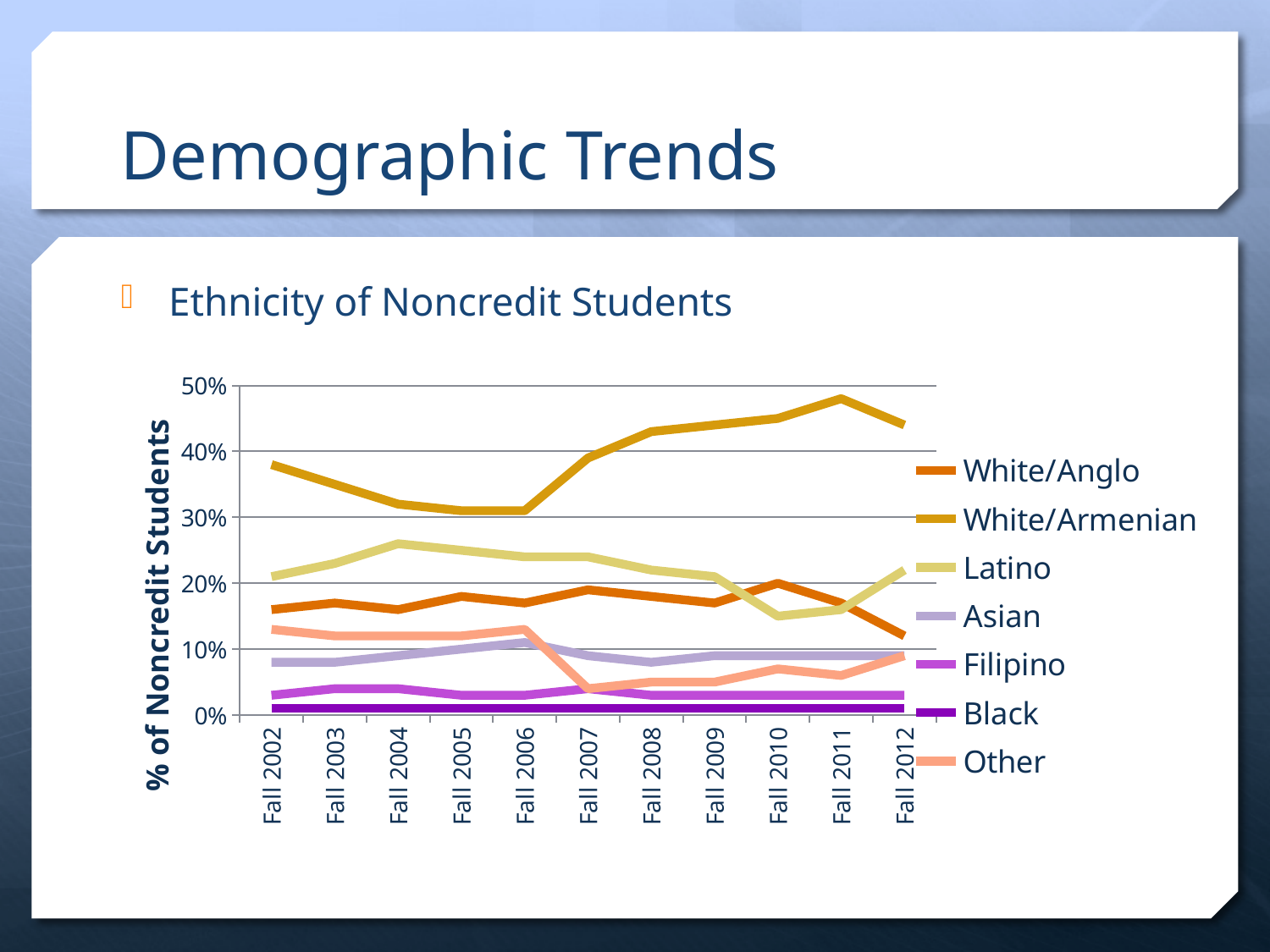
How many series does the legend list? 7 Which ethnicity has the highest percentage of noncredit students in Fall 2012? White/Armenian How many Fall terms are plotted along the x axis? 11 Is the White/Armenian value for Fall 2011 greater or less than 40%? greater Which ethnicity has the lowest percentage of noncredit students in Fall 2012? Black Is the White/Anglo value for Fall 2012 greater or less than 20%? less What is the label on the y axis of the chart? % of Noncredit Students In Fall 2012, which is larger: the Latino value or the White/Anglo value? Latino Is the Latino value for Fall 2004 greater or less than 20%? greater Does the White/Anglo line rise or fall from Fall 2010 to Fall 2012? falls What kind of chart is shown on the slide? Line chart Does the White/Armenian line rise or fall from Fall 2006 to Fall 2011? rises